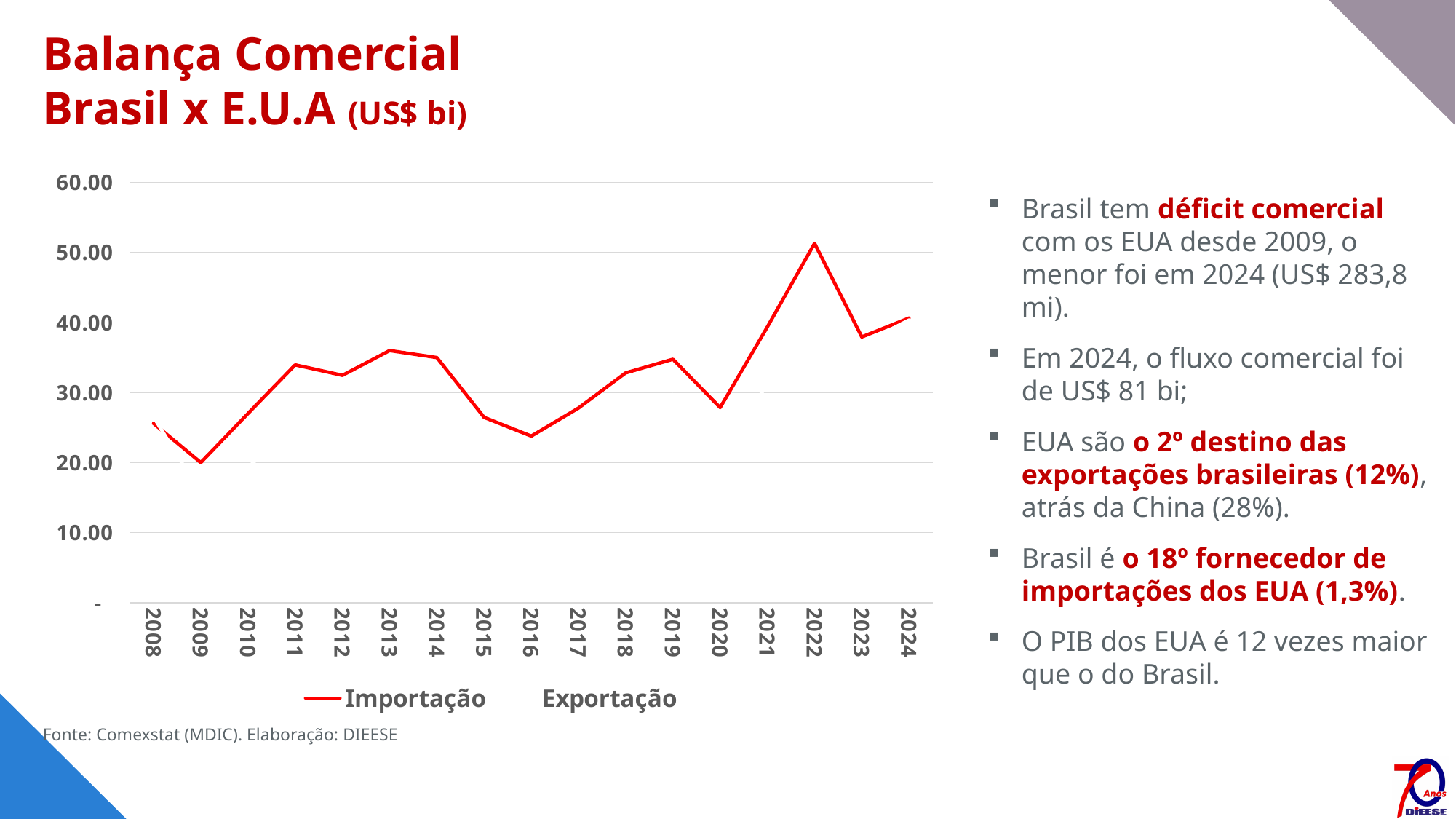
Which year has a higher Importação value, 2022 or 2023? 2022 Is the Importação value for 2013 greater or less than 30? greater Is the Importação value for 2020 greater or less than 30? less Does the Importação line rise or fall from 2020 to 2022? rise In which year does the Importação line reach its highest value? 2022 In which year does the Importação line reach its lowest value? 2009 How many series does the chart legend list? 2 What kind of chart is shown on the slide? line chart How many years are shown on the x axis of the chart? 17 Is the Importação value for 2016 greater or less than 30? less What are the two series named in the chart legend? Importação and Exportação What unit is given in the chart title? US$ bi